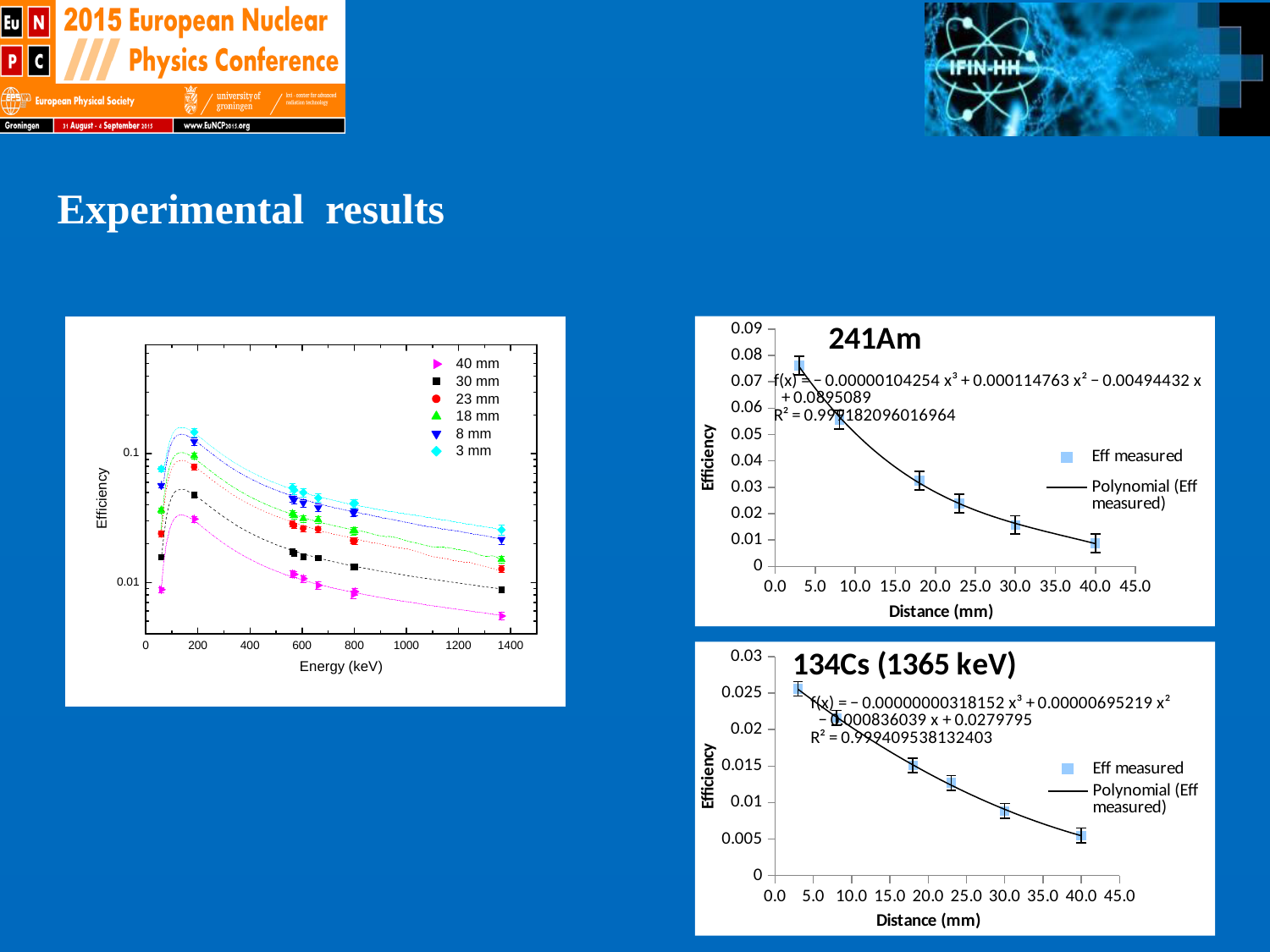
On the 134Cs (1365 keV) chart, what R² value is printed for the polynomial fit? 0.999409538132403 On the 134Cs (1365 keV) chart, is the efficiency at 40 mm greater or less than 0.01? less On the 134Cs (1365 keV) chart, how many entries does the legend list? 2 On the 241Am chart, how many measured data points are plotted? 6 On the left chart (Efficiency vs Energy), which series has the lowest efficiency at around 1400 keV? 40 mm On the left chart (Efficiency vs Energy), how many series does the legend list? 6 On the left chart (Efficiency vs Energy), what is the x-axis label? Energy (keV) On the 134Cs (1365 keV) chart, which distance has the highest measured efficiency? 3 mm On the 241Am chart, is the efficiency at 3 mm greater or less than 0.07? greater On the left chart (Efficiency vs Energy), which series has the highest efficiency at around 1400 keV? 3 mm On the 241Am chart, do the efficiency values rise or fall as distance increases? fall On the 241Am chart, is the efficiency at 30 mm greater or less than 0.02? less